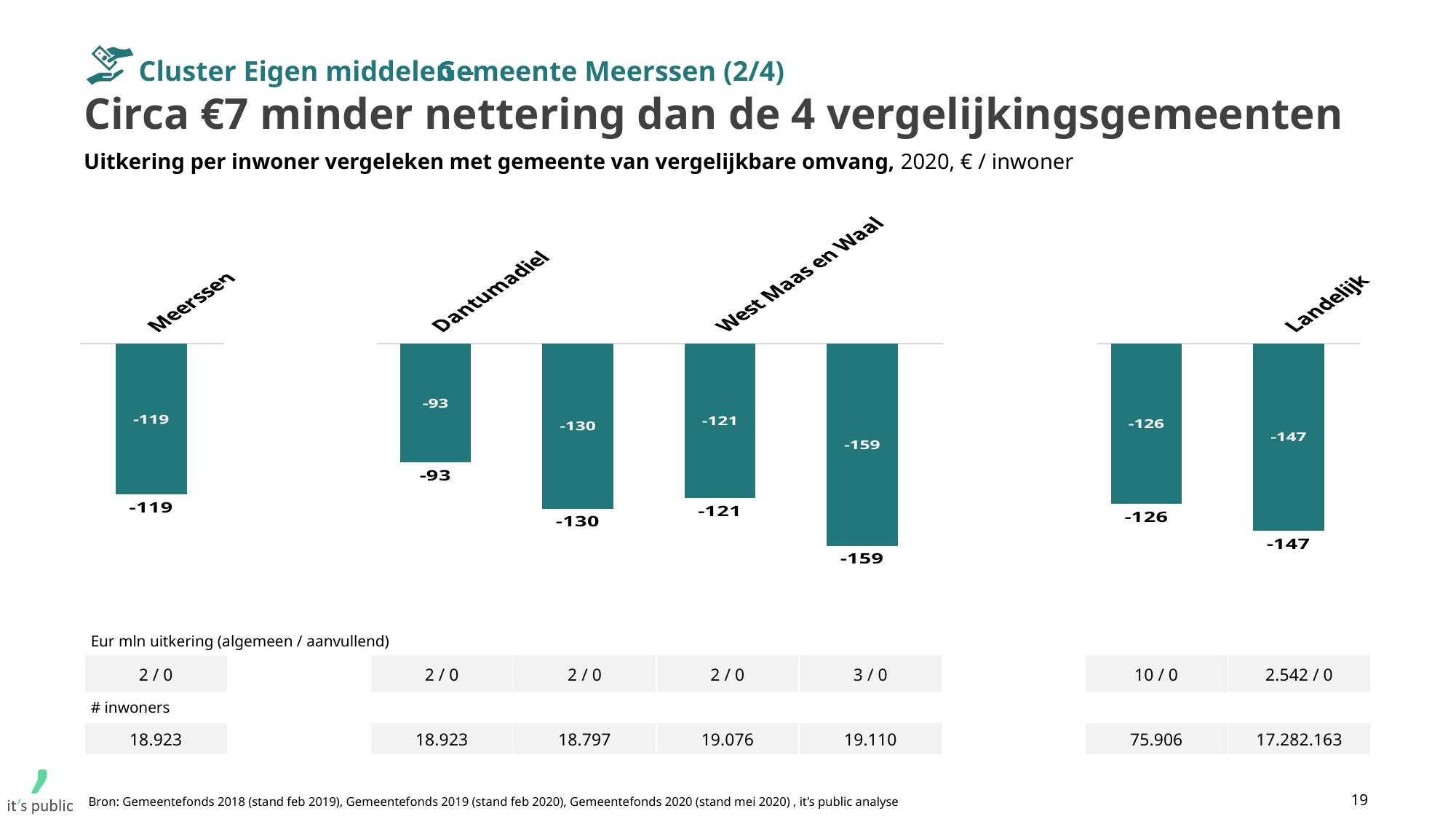
How many bars are plotted in the chart? 7 What is the value for Meerssen? -119 What is the value for Landelijk? -147 What is the value for West Maas en Waal? -121 Which is larger, the value for Meerssen or the value for Landelijk? Meerssen What is the difference between the values for Meerssen and Dantumadiel? 26 What kind of chart is shown on the slide? Bar chart Which labelled category has the highest value (closest to zero)? Dantumadiel What unit does the chart subtitle say the values are in? € / inwoner What is the difference between the values for Meerssen and Landelijk? 28 What is the value for Dantumadiel? -93 What is the lowest (most negative) value shown in the chart? -159